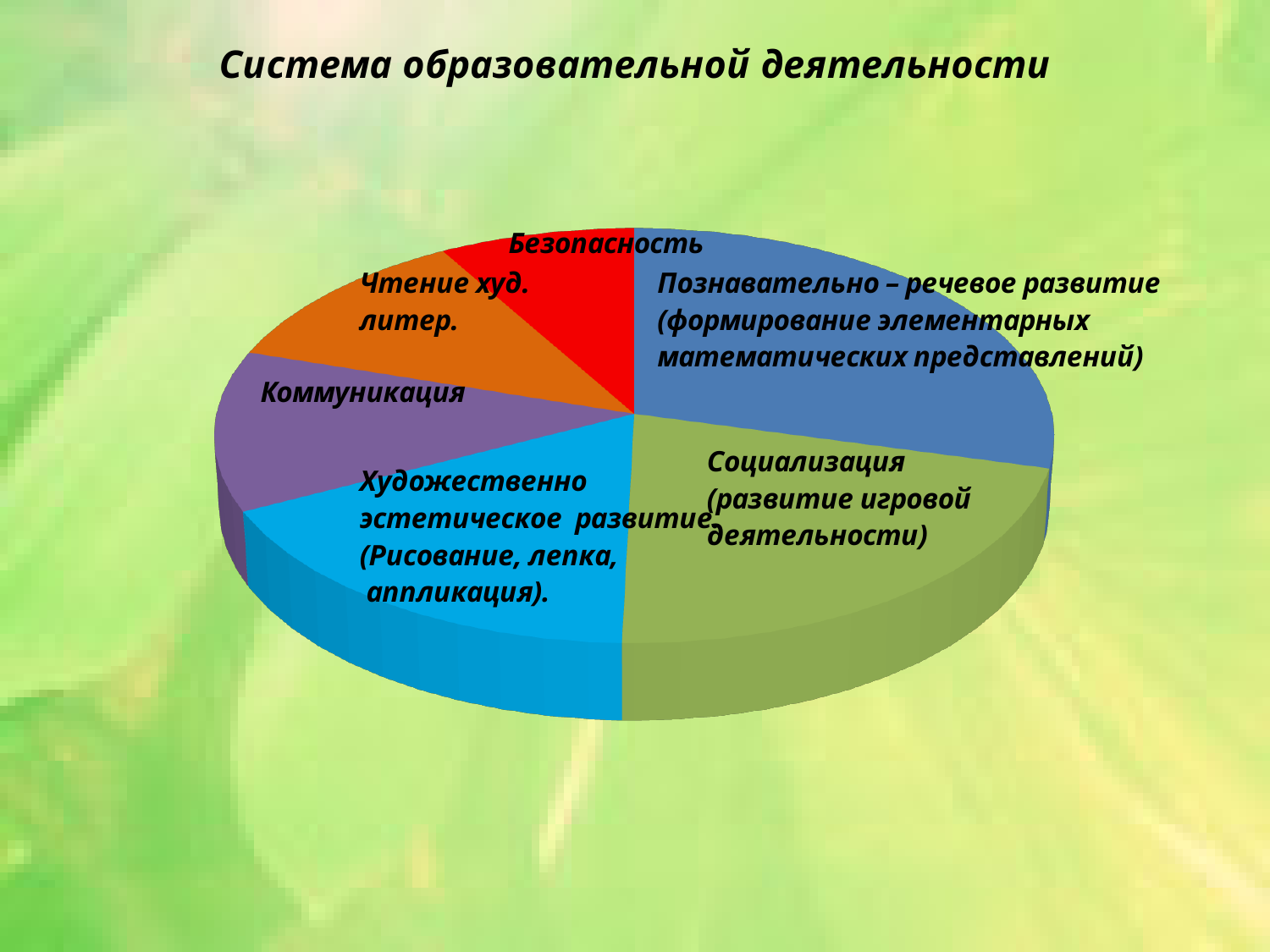
What colour is the Безопасность slice of the pie chart? red How many slices does the pie chart have? 6 Which slice is larger: Познавательно – речевое развитие or Безопасность? Познавательно – речевое развитие Which slice is larger: Социализация or Чтение худ. литер.? Социализация What kind of chart is shown on the slide? pie chart Which slice is larger: Художественно эстетическое развитие or Безопасность? Художественно эстетическое развитие Which slice of the pie chart is the smallest? Безопасность What is the title of the slide with the pie chart? Система образовательной деятельности